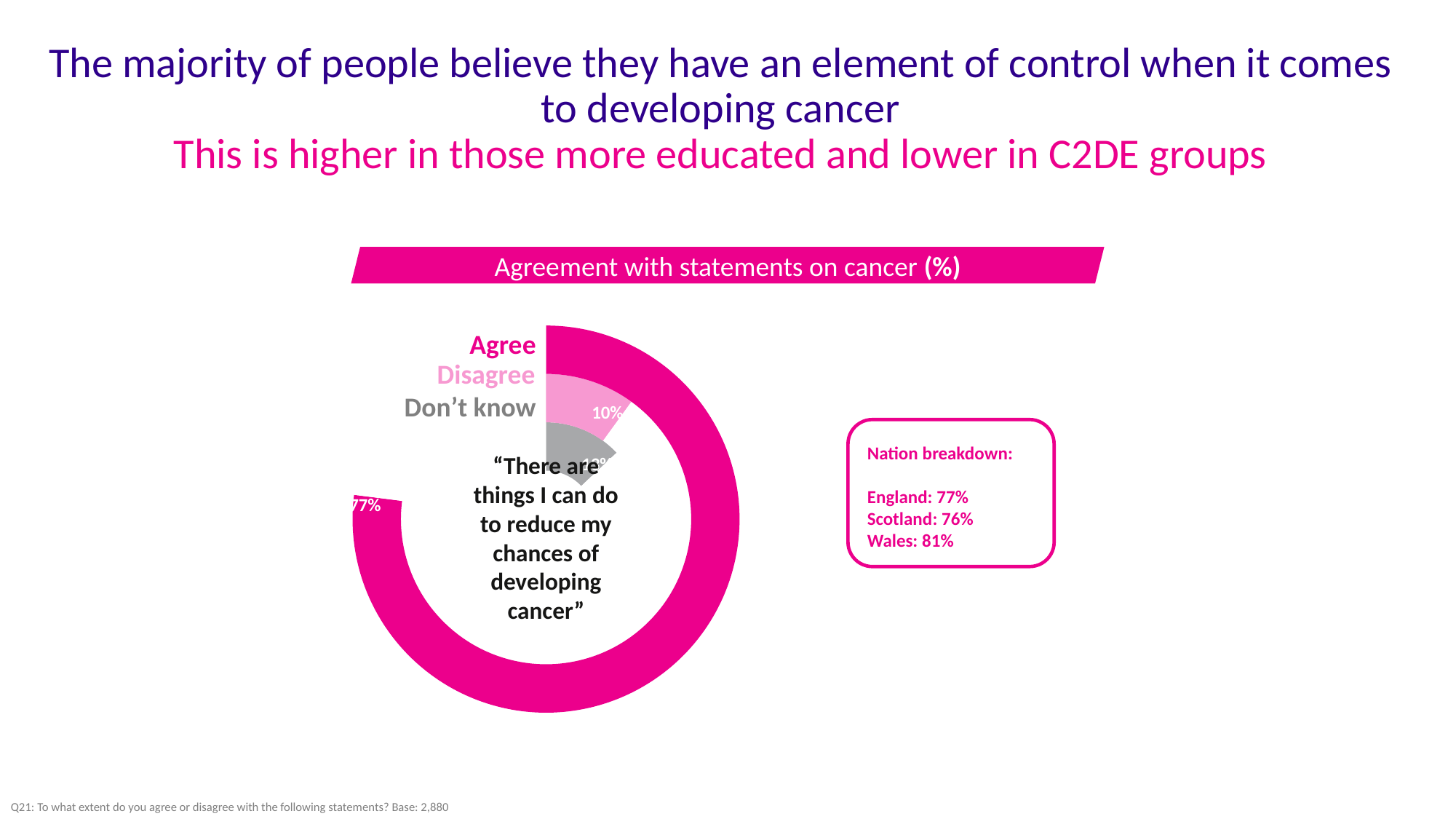
How many response categories does the chart legend list? 3 What percentage of people agree with the statement "There are things I can do to reduce my chances of developing cancer"? 77% What is the title shown above the chart? Agreement with statements on cancer (%) What is the difference in percentage points between those who agree and those who disagree with the statement? 67 Which response category has the largest share of the doughnut chart? Agree Which colour represents the "Agree" category in the chart? Dark pink Is the share of people who agree with the statement greater or less than 50%? greater What kind of chart is used to show agreement with the statement on cancer? Doughnut chart What percentage of people disagree with the statement "There are things I can do to reduce my chances of developing cancer"? 10% According to the nation breakdown, what percentage of people in Wales agree with the statement? 81% Which response category has the smallest share of the doughnut chart? Disagree Which is larger, the share who agree or the share who disagree? Agree